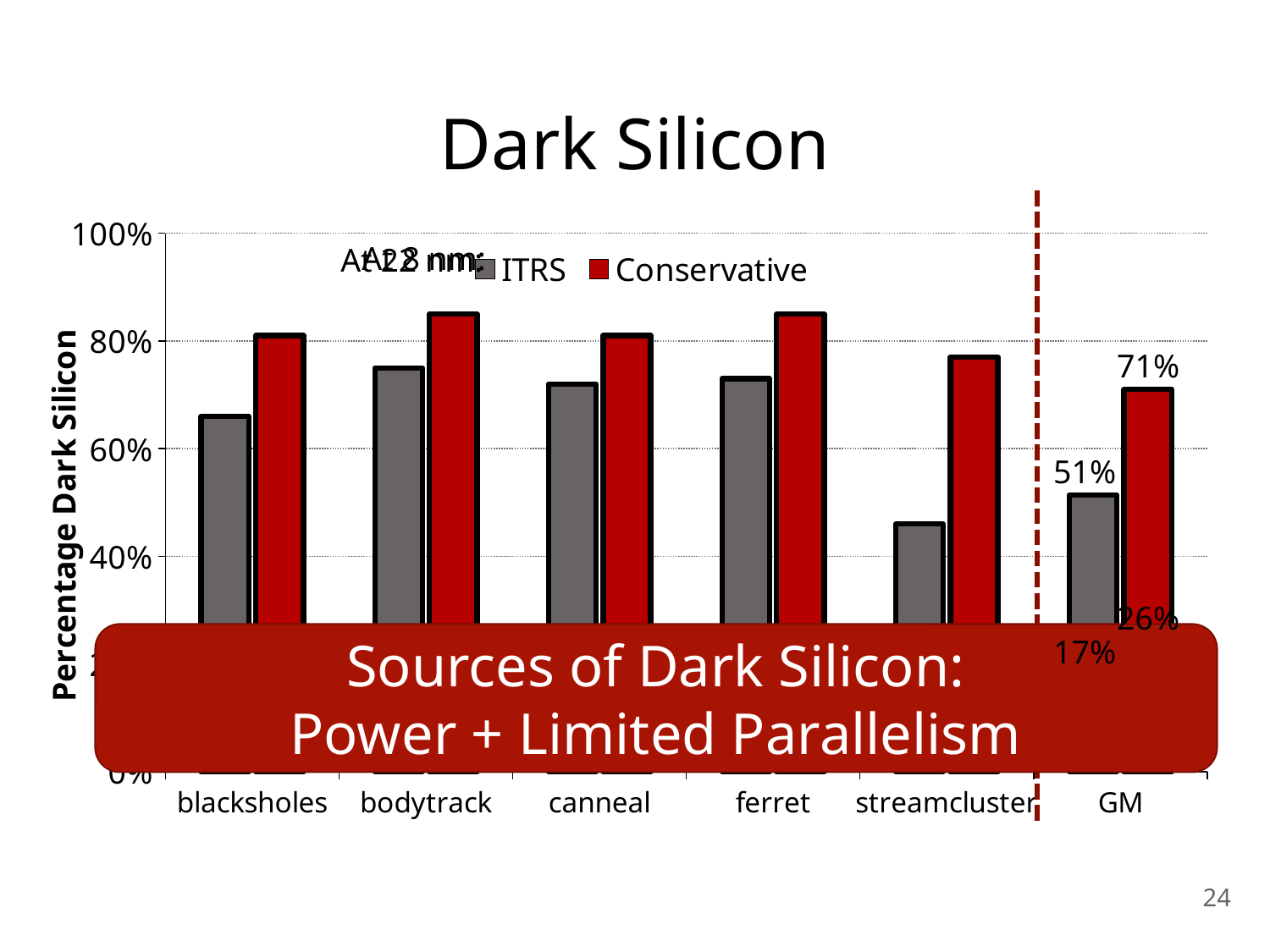
How many series does the legend list? 2 For blacksholes, which is larger: the ITRS value or the Conservative value? Conservative What is the ITRS value for GM? 51% What is the difference between the Conservative and ITRS values for GM? 20% What is the Conservative value for GM? 71% Is the Conservative value for bodytrack greater or less than 80%? greater Is the ITRS value for blacksholes greater or less than 60%? greater What kind of chart is shown on the slide? Bar chart What is the title of the y axis? Percentage Dark Silicon Is the ITRS value for streamcluster greater or less than 60%? less How many categories are shown on the x axis? 6 Which category has the lowest ITRS value? streamcluster